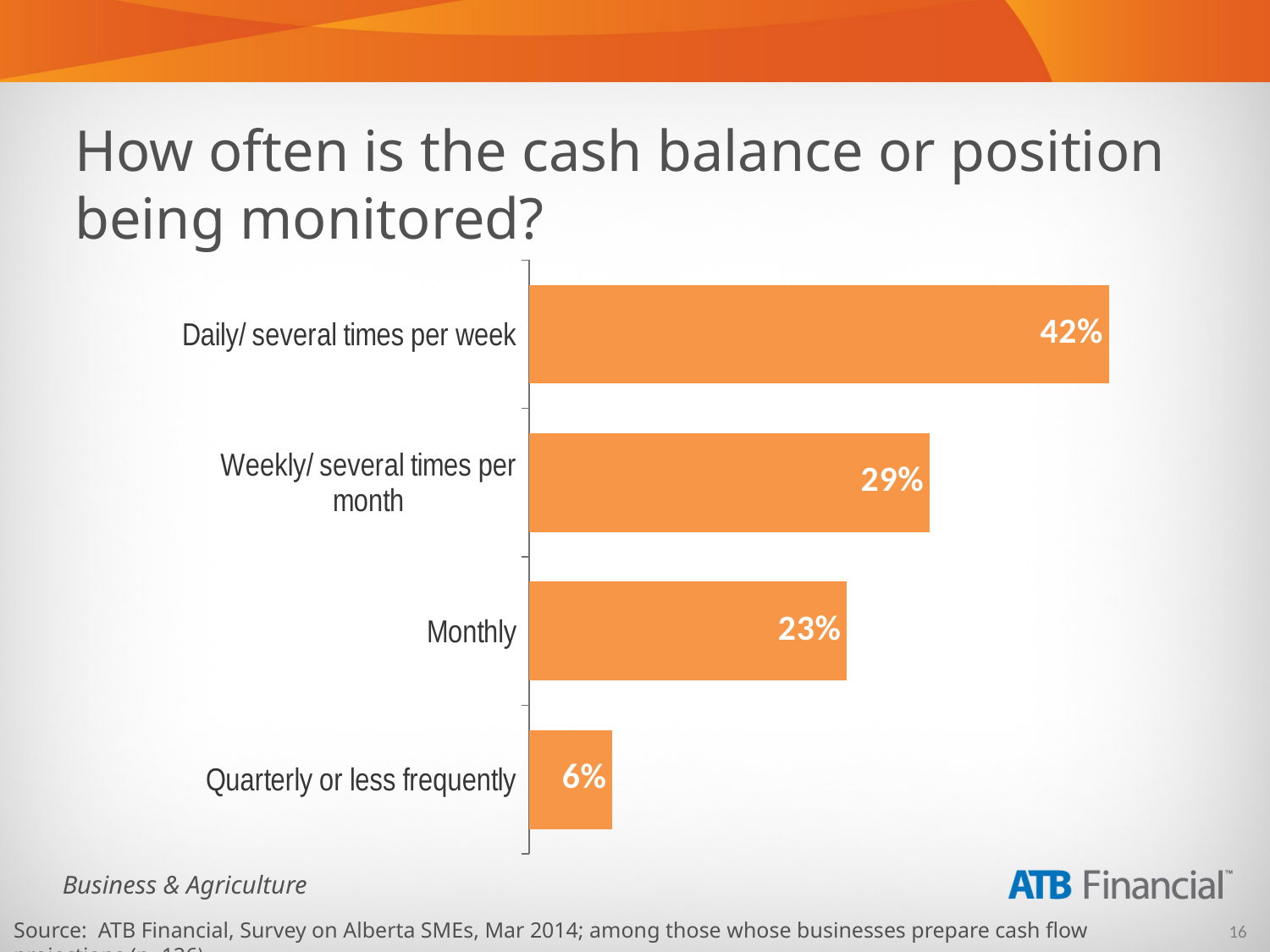
What is the value for 'Quarterly or less frequently'? 6% What is the value for 'Weekly/ several times per month'? 29% Which is larger: the value for 'Monthly' or the value for 'Weekly/ several times per month'? Weekly/ several times per month Which monitoring frequency has the highest percentage? Daily/ several times per week What is the title of the slide containing the chart? How often is the cash balance or position being monitored? What is the difference in percentage points between 'Daily/ several times per week' and 'Weekly/ several times per month'? 13 What percentage monitor their cash balance monthly? 23% How many categories are shown in the chart? 4 Which monitoring frequency has the lowest percentage? Quarterly or less frequently What percentage of respondents monitor their cash balance daily or several times per week? 42% What is the difference in percentage points between 'Monthly' and 'Quarterly or less frequently'? 17 What kind of chart is shown on the slide? Bar chart